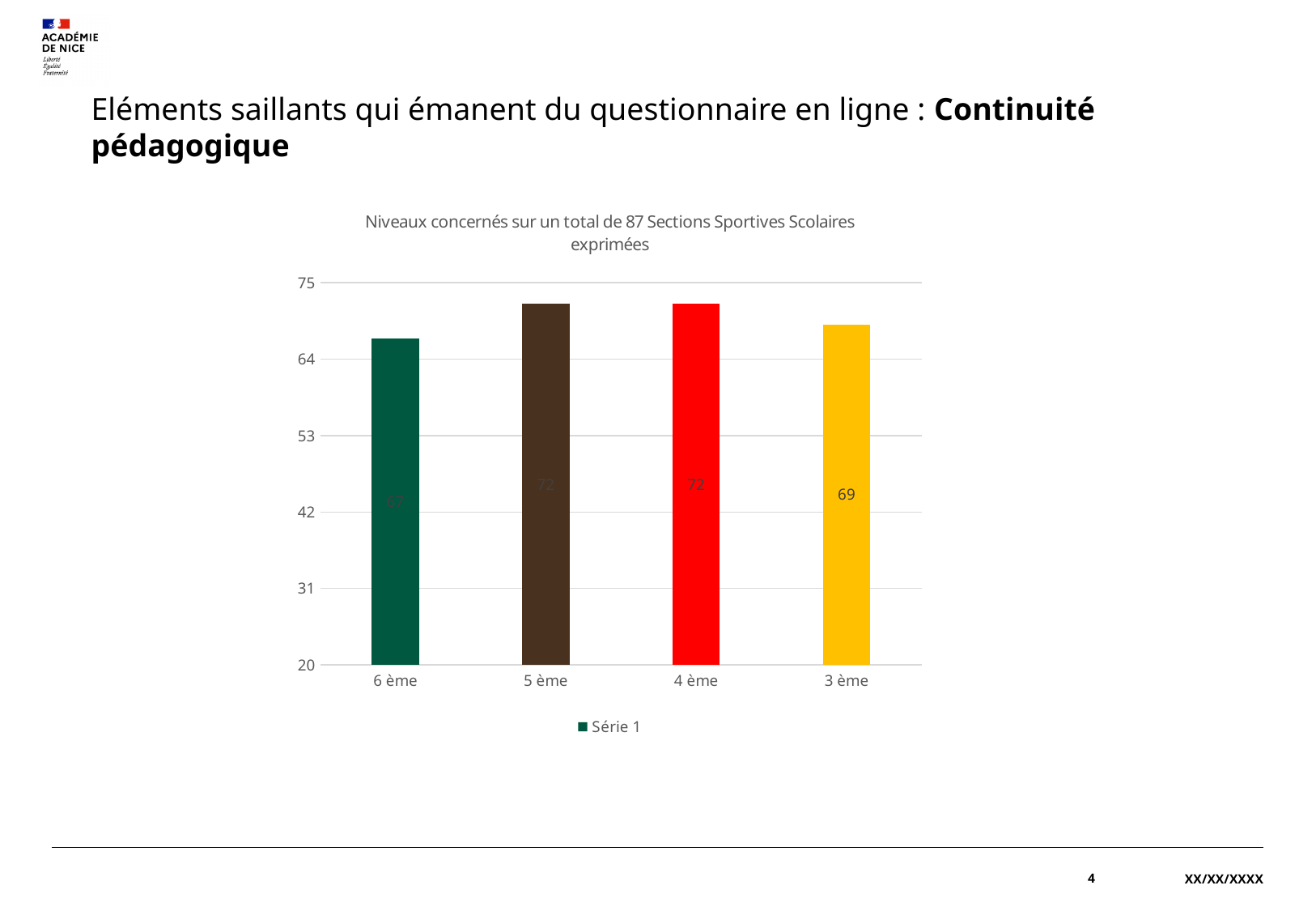
What is the value for 6 ème? 67 What is the name of the series shown in the legend? Série 1 Which category has the lowest value? 6 ème What is the difference between the values for 5 ème and 6 ème? 5 What is the value for 3 ème? 69 How many series does the legend list? 1 What is the value for 5 ème? 72 Which is larger, the value for 3 ème or the value for 6 ème? 3 ème What is the difference between the values for 3 ème and 6 ème? 2 How many categories are shown on the x axis? 4 What type of chart is shown on the slide? bar chart What is the value for 4 ème? 72